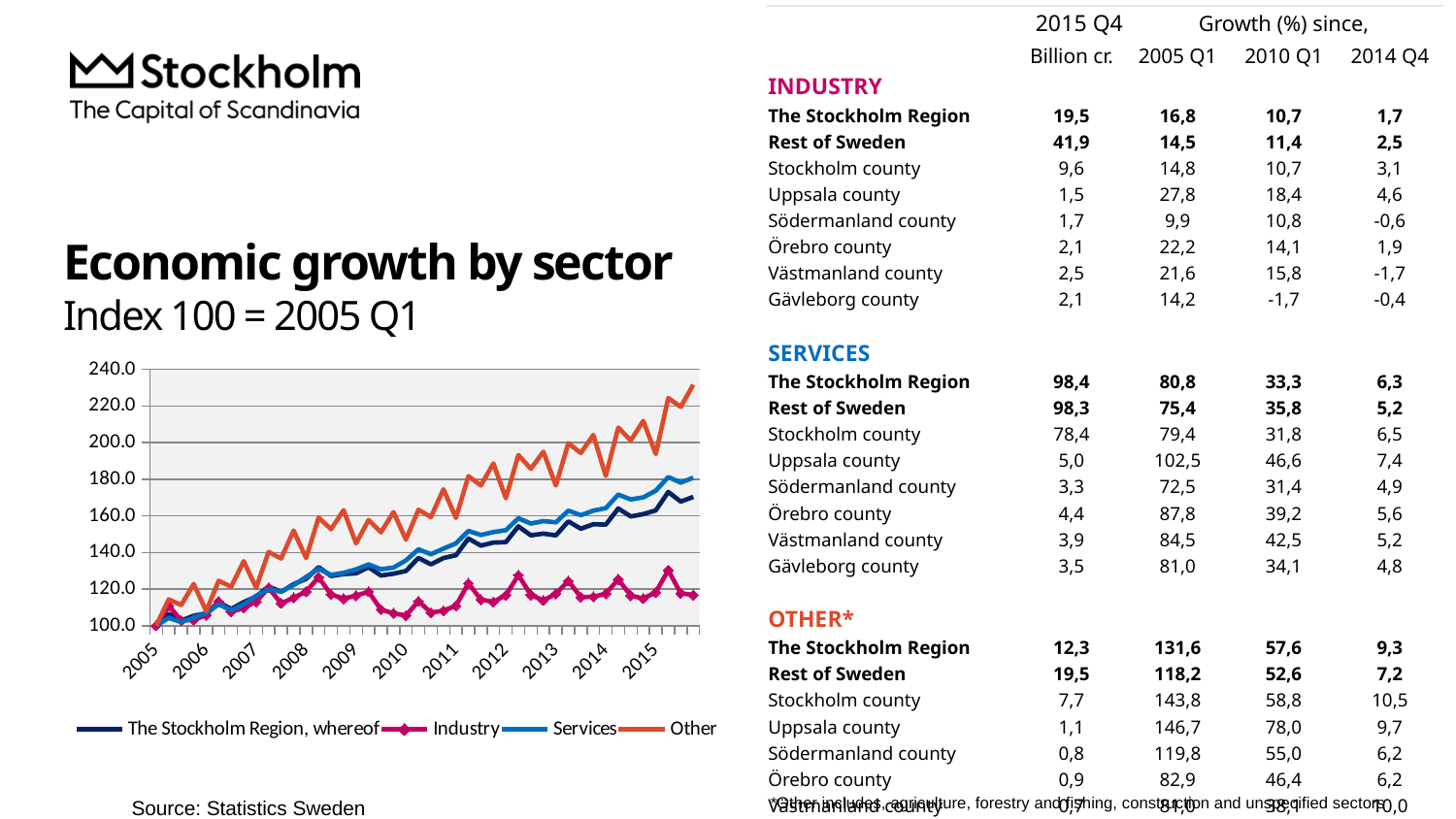
What is the title of the chart on the slide? Economic growth by sector Which series has the highest index value at the end of 2015? Other What kind of chart is shown on the slide? line chart Which series in the chart is drawn with diamond markers? Industry Is the value for Industry at the end of 2015 greater or less than 140? less Does the Services series rise or fall over the period from 2005 to 2015? rise Is the value for Services at the end of 2015 greater or less than 160? greater What is the index value of all series at the start of the chart in 2005 Q1? 100.0 At the end of 2015, which is larger: the value for Other or the value for Industry? Other Is the value for Other at the end of 2015 greater or less than 220? greater Which series has the lowest index value at the end of 2015? Industry How many series does the chart legend list? 4